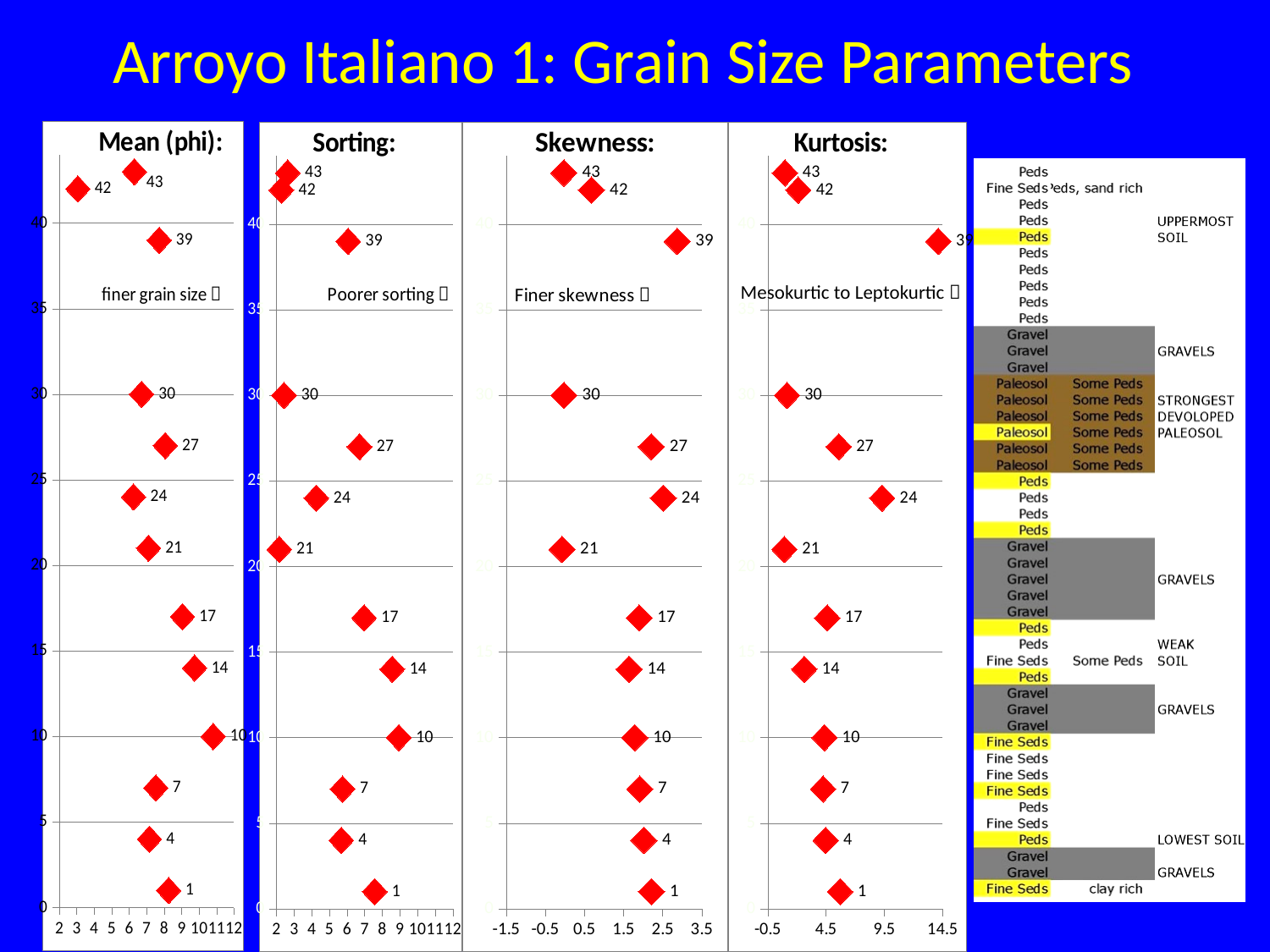
What kind of chart is the Mean (phi) chart? scatter chart How many data points are plotted in the Kurtosis chart? 13 In the Mean (phi) chart, is the value for sample 10 greater or less than 10? greater In the Mean (phi) chart, is the value for sample 42 greater or less than 5? less In the Skewness chart, is the value for sample 39 greater or less than 1.5? greater How many data points are plotted in the Sorting chart? 13 In the Mean (phi) chart, which has the larger value, sample 10 or sample 42? sample 10 In the Sorting chart, which has the larger value, sample 14 or sample 21? sample 14 What are the titles of the four charts on the slide, from left to right? Mean (phi), Sorting, Skewness, Kurtosis